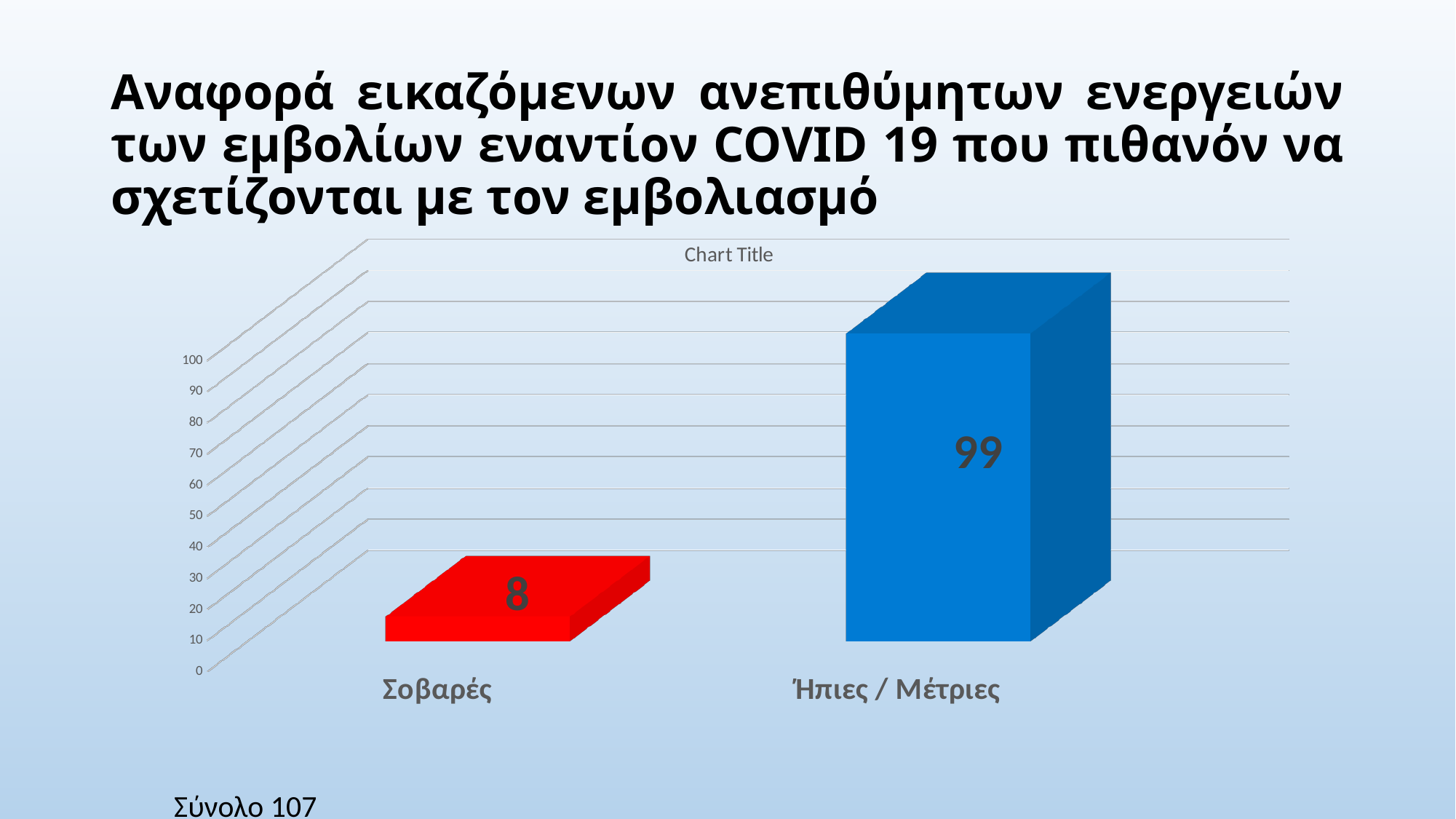
Is the value for Σοβαρές greater or less than 20? less What kind of chart is shown on the slide? bar chart What is the difference between the values for Ήπιες / Μέτριες and Σοβαρές? 91 What is the sum of the two values shown in the chart? 107 Which category has the lowest value? Σοβαρές What is the value for Σοβαρές? 8 Which category has the highest value? Ήπιες / Μέτριες Which is larger, the value for Σοβαρές or the value for Ήπιες / Μέτριες? Ήπιες / Μέτριες How many categories are shown in the chart? 2 What colour is the bar for Σοβαρές? red What is the value for Ήπιες / Μέτριες? 99 Is the value for Ήπιες / Μέτριες greater or less than 90? greater